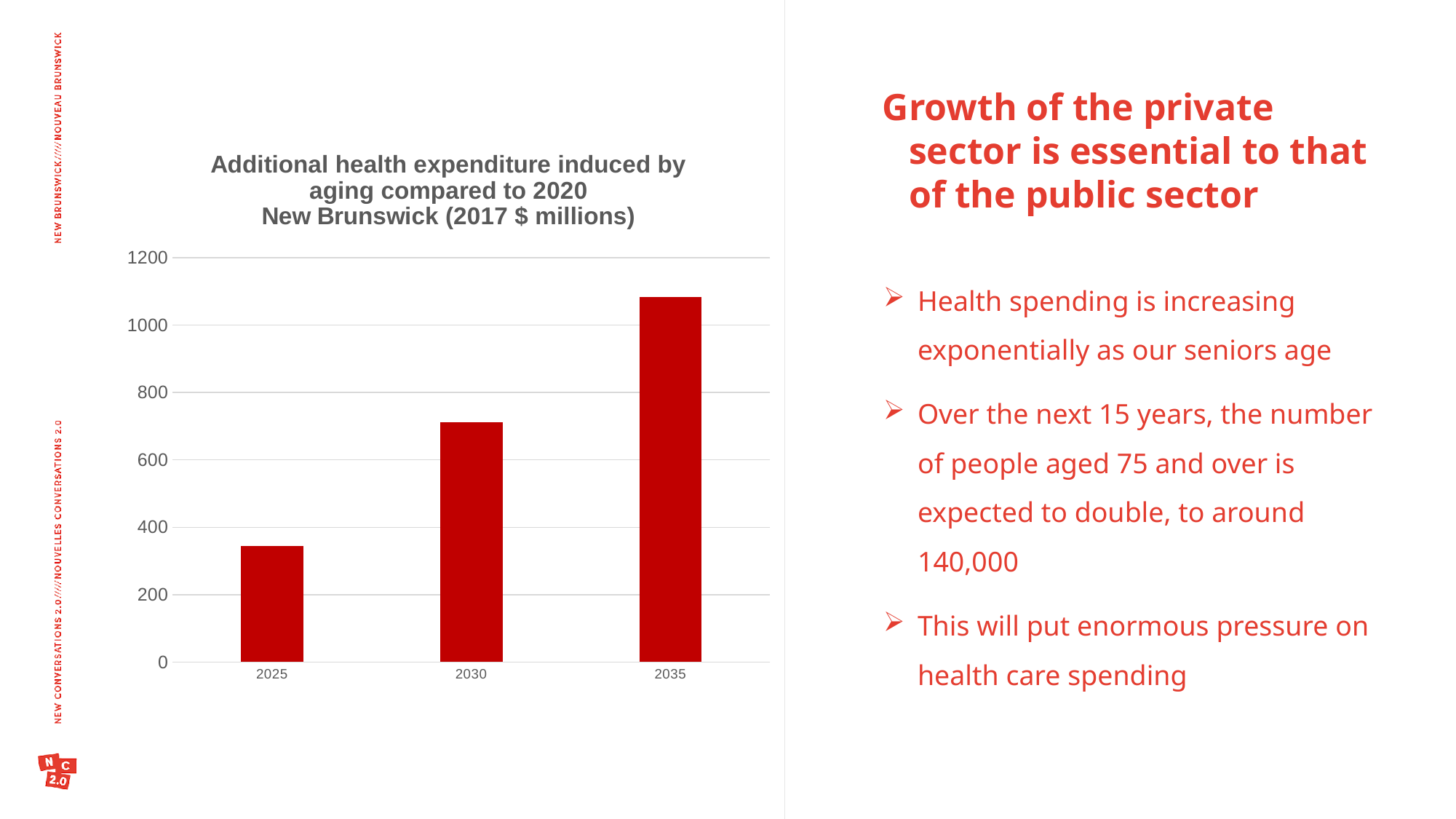
Which year has the lowest additional health expenditure? 2025 What kind of chart is shown on the slide? bar chart In what units are the chart values expressed, according to the title? 2017 $ millions How many years (categories) are plotted on the chart? 3 Which year has the highest additional health expenditure? 2035 Is the value for 2025 greater or less than 200? greater Is the value for 2035 greater or less than 1000? greater Which is larger, the value for 2030 or the value for 2035? 2035 Do the values rise or fall from 2025 to 2035? rise Is the value for 2025 greater or less than 400? less